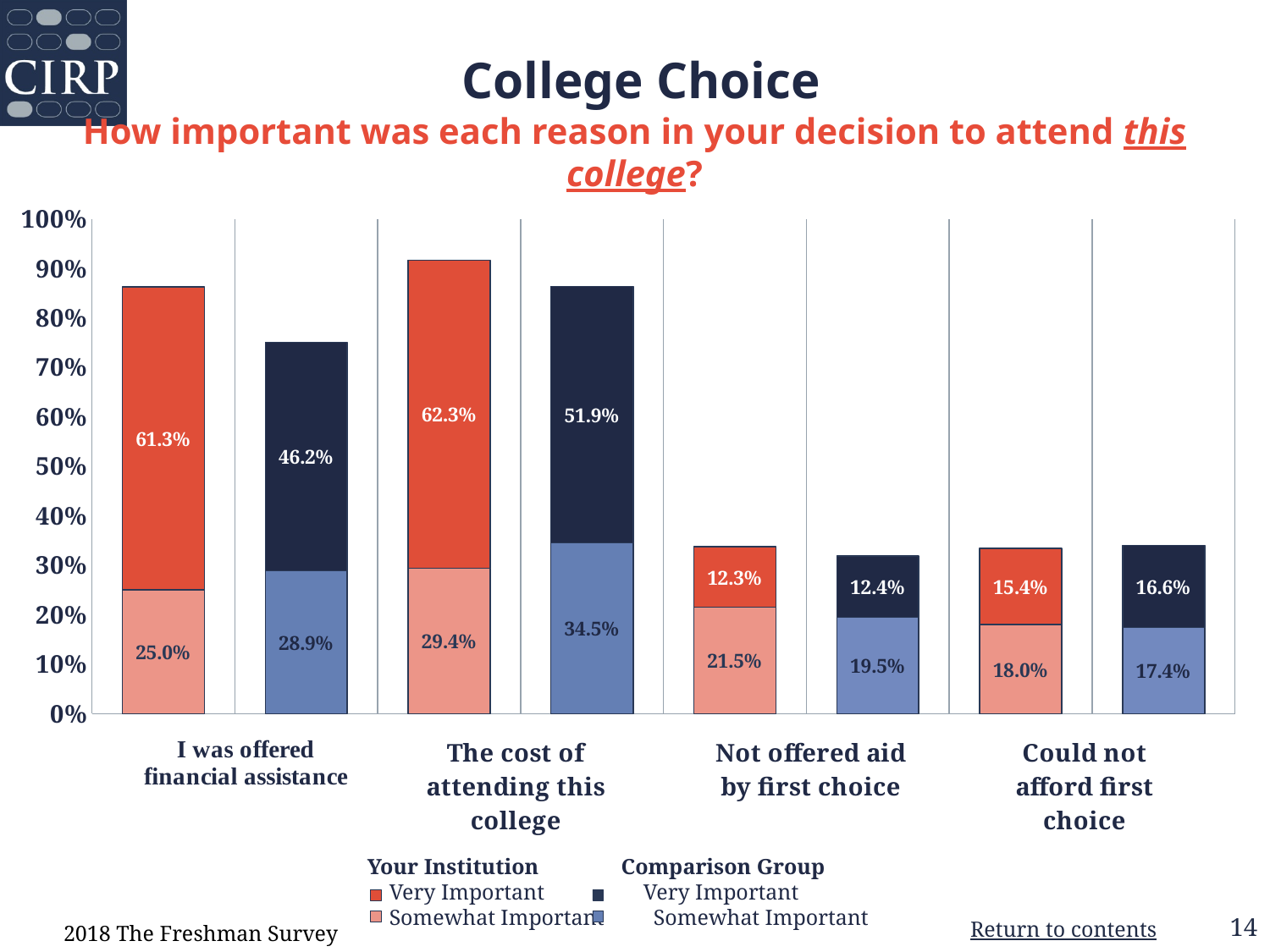
What percentage of the Comparison Group rated "The cost of attending this college" as Somewhat Important? 34.5% What percentage of Your Institution respondents rated "Could not afford first choice" as Somewhat Important? 18.0% For "Not offered aid by first choice", which is larger: Your Institution's Somewhat Important percentage or the Comparison Group's Somewhat Important percentage? Your Institution (21.5%) What is the total percentage (Very Important plus Somewhat Important) for the Comparison Group on "I was offered financial assistance"? 75.1% What is the difference between Your Institution's and the Comparison Group's Very Important percentages for "I was offered financial assistance"? 15.1% What percentage of Your Institution respondents rated "I was offered financial assistance" as Very Important? 61.3% What is the total percentage (Very Important plus Somewhat Important) for Your Institution on "The cost of attending this college"? 91.7% What type of chart is shown on the slide? Stacked bar chart How many entries does the chart legend list? 4 How many reasons (categories) are shown on the x axis of the chart? 4 Which reason has the highest Very Important percentage for Your Institution? The cost of attending this college Which reason has the lowest Very Important percentage for the Comparison Group? Not offered aid by first choice